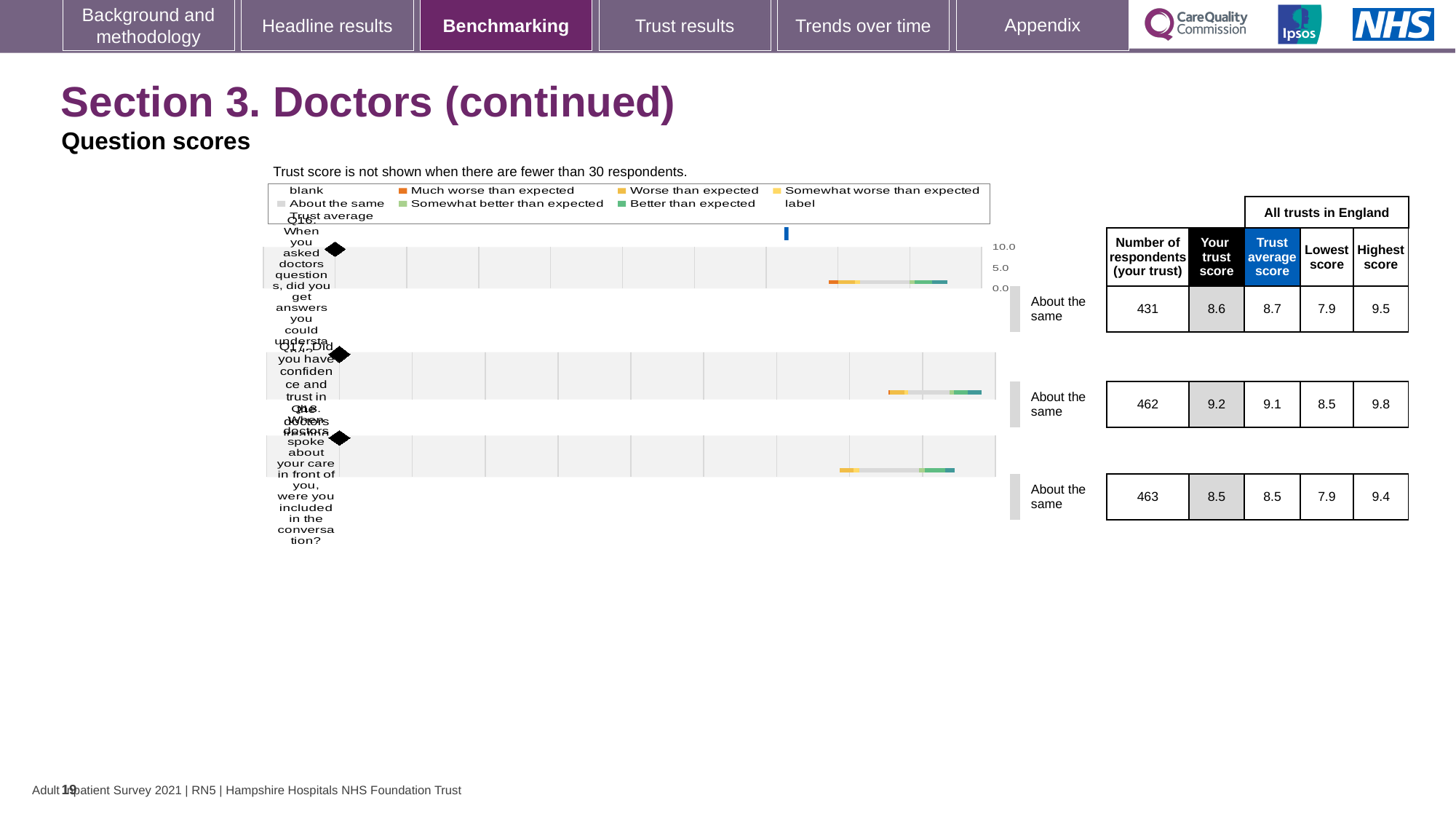
What is the lowest score across all trusts in England for Q16? 7.9 Which question has the lowest 'Your trust score'? Q18 For Q17, which is larger: your trust score or the trust average score? Your trust score What is the difference between the highest score and the lowest score for Q16? 1.6 What is the highest score across all trusts in England for Q17? 9.8 How many respondents from your trust answered Q16 (When you asked doctors questions, did you get answers you could understand)? 431 Which question has the highest 'Your trust score'? Q17 How many questions are plotted on the chart? 3 What is your trust score for Q17 (Did you have confidence and trust in the doctors treating you)? 9.2 What is the trust average score for Q18 (When doctors spoke about your care in front of you, were you included in the conversation)? 8.5 What benchmark category is shown next to each of the three questions? About the same What kind of chart is used to show the question scores? Bar chart